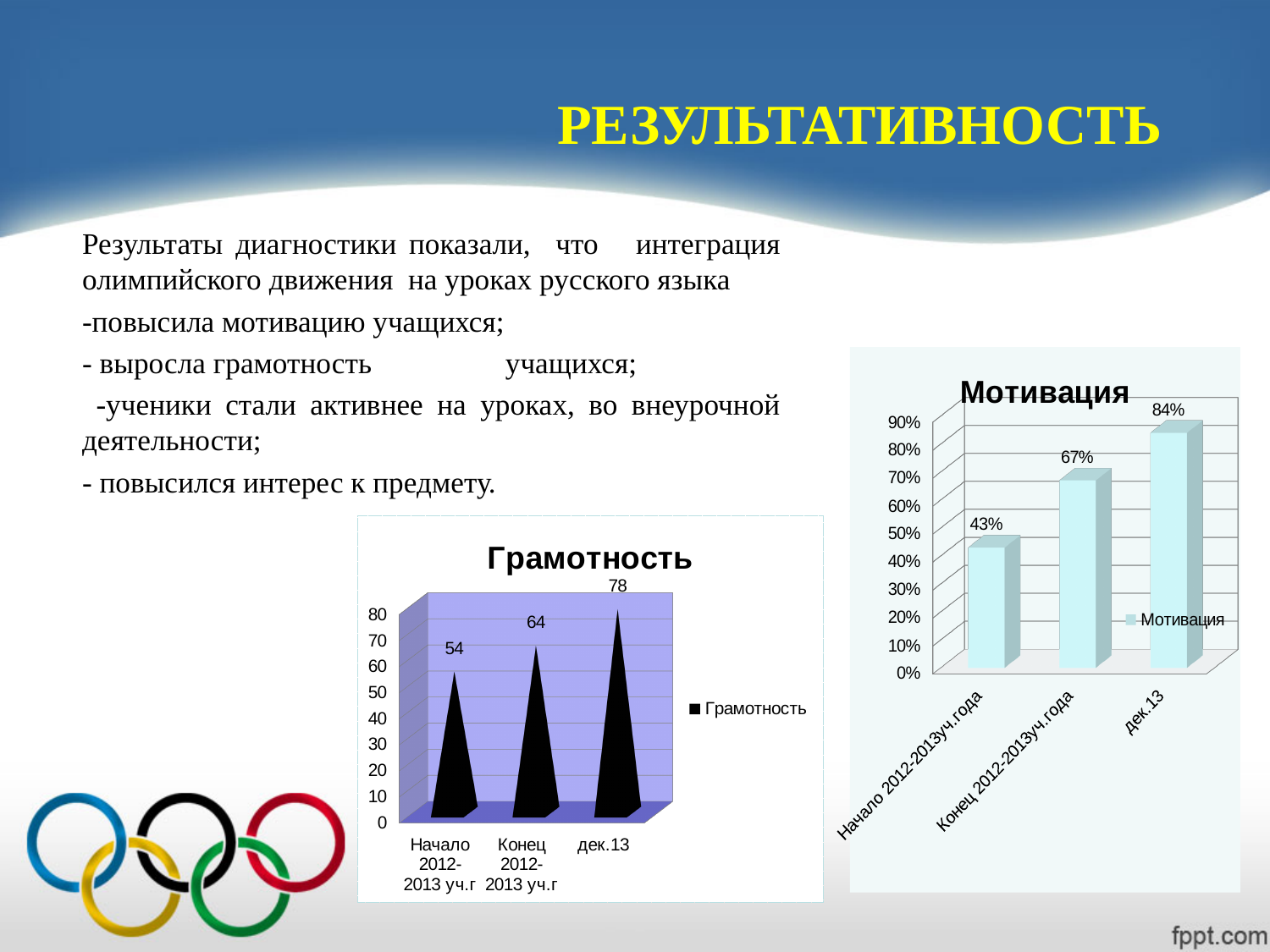
In the 'Мотивация' chart, which category has the highest value? дек.13 In the 'Грамотность' chart, which category has the lowest value? Начало 2012-2013 уч.г In the 'Грамотность' chart, how many categories are shown on the x axis? 3 In the 'Грамотность' chart, what is the value for 'дек.13'? 78 In the 'Мотивация' chart, what is the value for 'Конец 2012-2013уч.года'? 67% In the 'Мотивация' chart, what is the value for 'Начало 2012-2013уч.года'? 43% How many series does the legend of the 'Мотивация' chart list? 1 In the 'Грамотность' chart, do the values rise or fall from left to right along the x axis? rise In the 'Мотивация' chart, what is the difference between the values for 'дек.13' and 'Начало 2012-2013уч.года'? 41% In the 'Грамотность' chart, what is the value for 'Начало 2012-2013 уч.г'? 54 What kind of chart is the 'Мотивация' chart? bar chart In the 'Грамотность' chart, what is the difference between the values for 'дек.13' and 'Конец 2012-2013 уч.г'? 14